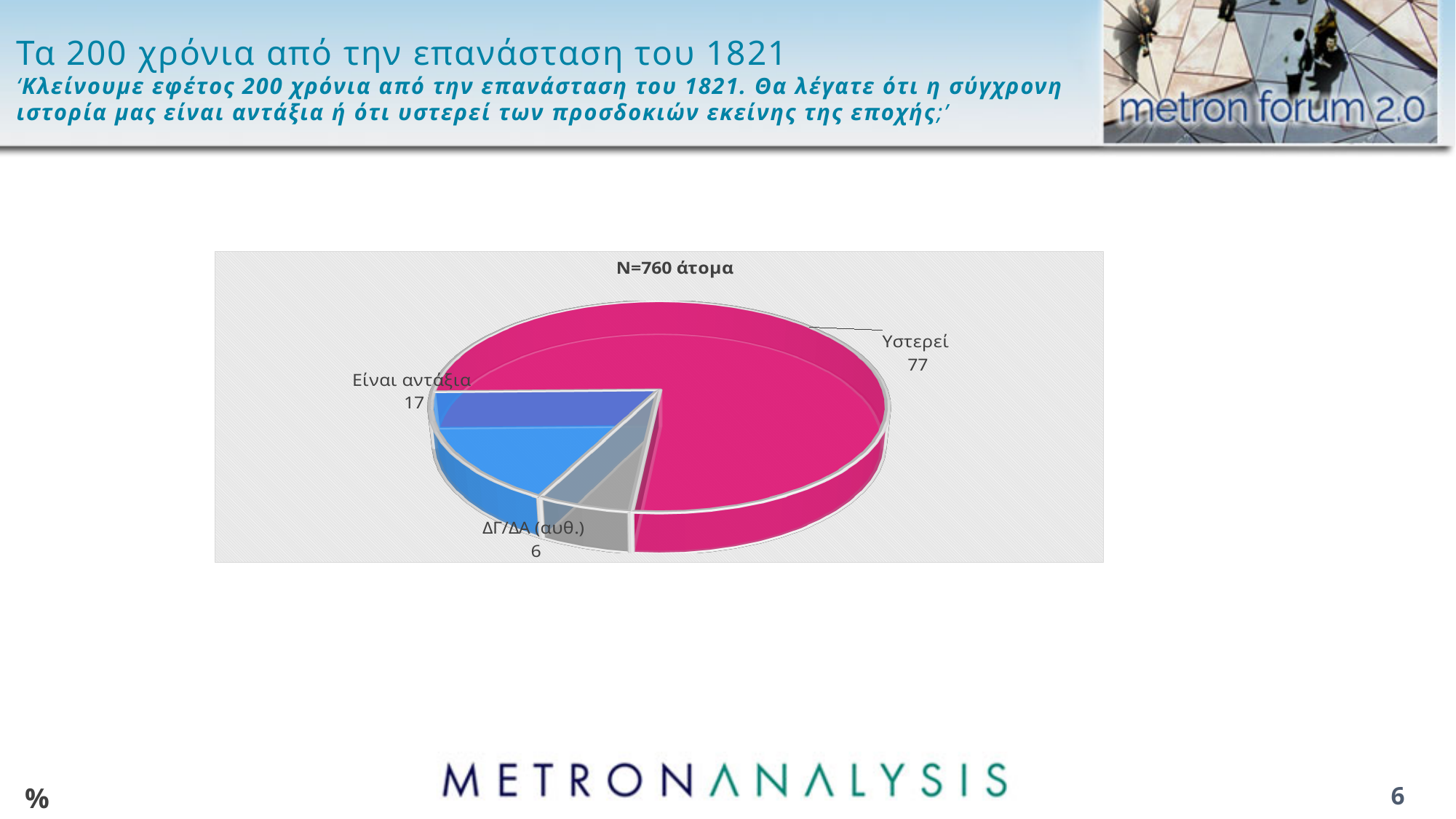
Which category has the smallest slice? ΔΓ/ΔΑ (αυθ.) What is the value for Υστερεί? 77 What is the title of the chart? N=760 άτομα Which is larger, the value for Είναι αντάξια or the value for ΔΓ/ΔΑ (αυθ.)? Είναι αντάξια What is the difference between the values for Είναι αντάξια and ΔΓ/ΔΑ (αυθ.)? 11 What colour is the slice for Υστερεί? Magenta (pink) Which category has the largest slice? Υστερεί What kind of chart is shown on the slide? Pie chart What is the value for ΔΓ/ΔΑ (αυθ.)? 6 What is the value for Είναι αντάξια? 17 What is the difference between the values for Υστερεί and Είναι αντάξια? 60 How many slices does the pie chart have? 3